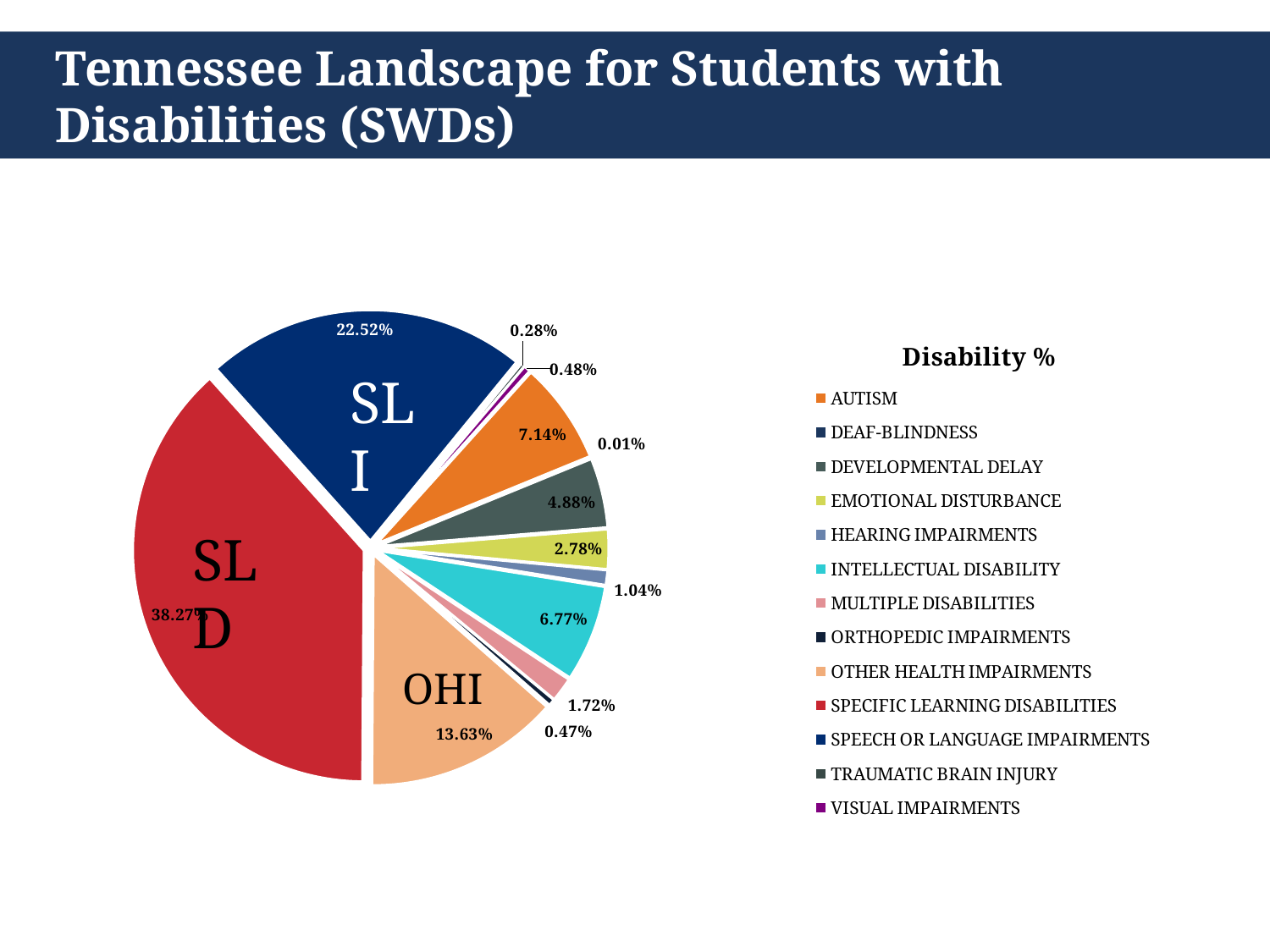
What is the smallest percentage labelled on the pie chart? 0.01% What percentage is shown for the SLI (Speech or Language Impairments) slice? 22.52% What percentage is shown for the Autism slice? 7.14% How many categories does the legend of the pie chart list? 13 What kind of chart is shown on the slide? pie chart What percentage is shown for the SLD (Specific Learning Disabilities) slice? 38.27% What is the difference between the SLD slice (38.27%) and the SLI slice (22.52%)? 15.75% What percentage is shown for the Intellectual Disability slice? 6.77% What is the title of the chart's legend? Disability % Which is larger, the Autism slice or the Intellectual Disability slice? Autism What percentage is shown for the OHI (Other Health Impairments) slice? 13.63% Which category has the largest slice of the pie? Specific Learning Disabilities (SLD)